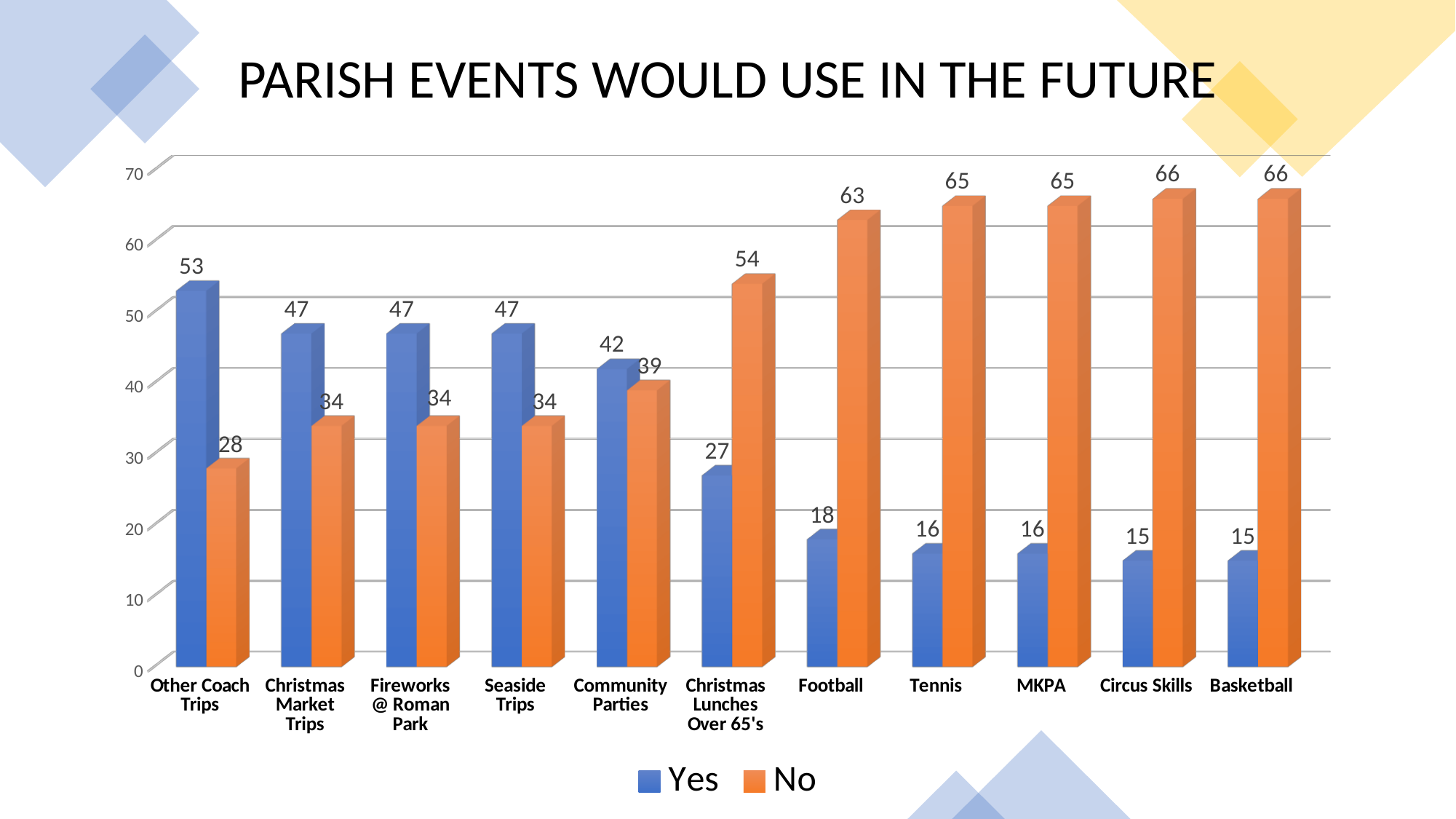
Which is larger for Community Parties, the 'Yes' value or the 'No' value? Yes What is the 'No' value for Christmas Lunches Over 65's? 54 What is the 'Yes' value for Football? 18 How many categories are shown on the x axis? 11 What kind of chart is shown on the slide? Bar chart Which category has the highest 'Yes' value? Other Coach Trips What is the 'Yes' value for Other Coach Trips? 53 Which colour represents the 'No' series? Orange What is the difference between the 'No' and 'Yes' values for Tennis? 49 How many series does the legend list? 2 What is the title of the chart? PARISH EVENTS WOULD USE IN THE FUTURE Which category has the lowest 'No' value? Other Coach Trips